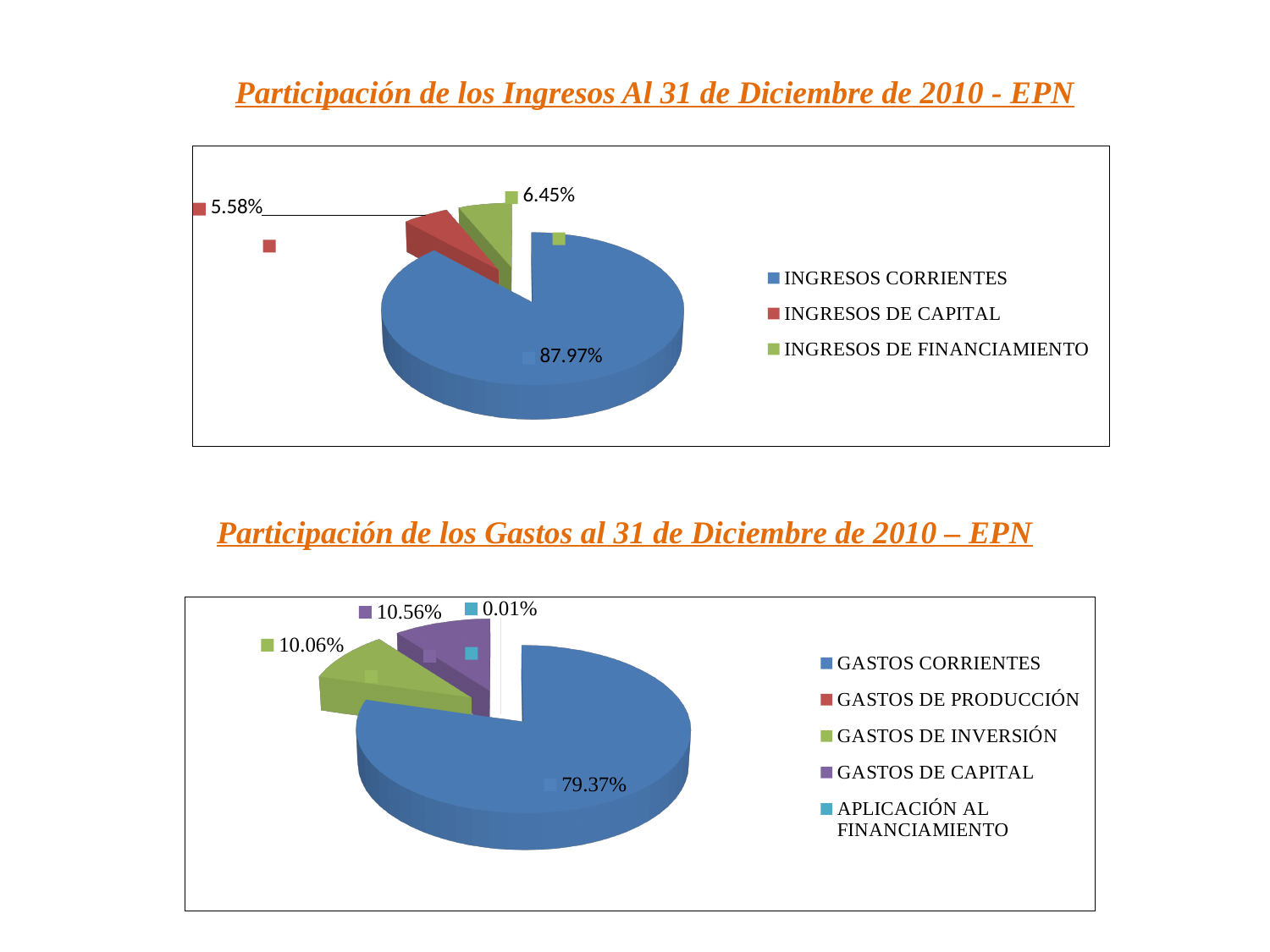
In the bottom chart (Participación de los Gastos), which is larger: GASTOS DE CAPITAL or GASTOS DE INVERSIÓN? GASTOS DE CAPITAL In the top chart (Participación de los Ingresos), what share does INGRESOS DE FINANCIAMIENTO have? 6.45% In the bottom chart (Participación de los Gastos), what share does GASTOS CORRIENTES have? 79.37% In the top chart (Participación de los Ingresos), how many entries does the legend list? 3 In the bottom chart (Participación de los Gastos), what share does GASTOS DE INVERSIÓN have? 10.06% In the top chart (Participación de los Ingresos), what share does INGRESOS DE CAPITAL have? 5.58% In the top chart (Participación de los Ingresos), which category has the largest share? INGRESOS CORRIENTES In the top chart (Participación de los Ingresos), which category has the smallest share? INGRESOS DE CAPITAL In the bottom chart (Participación de los Gastos), what share does APLICACIÓN AL FINANCIAMIENTO have? 0.01% What kind of chart is the bottom chart (Participación de los Gastos)? Pie chart In the bottom chart (Participación de los Gastos), how many entries does the legend list? 5 In the top chart (Participación de los Ingresos), what share does INGRESOS CORRIENTES have? 87.97%